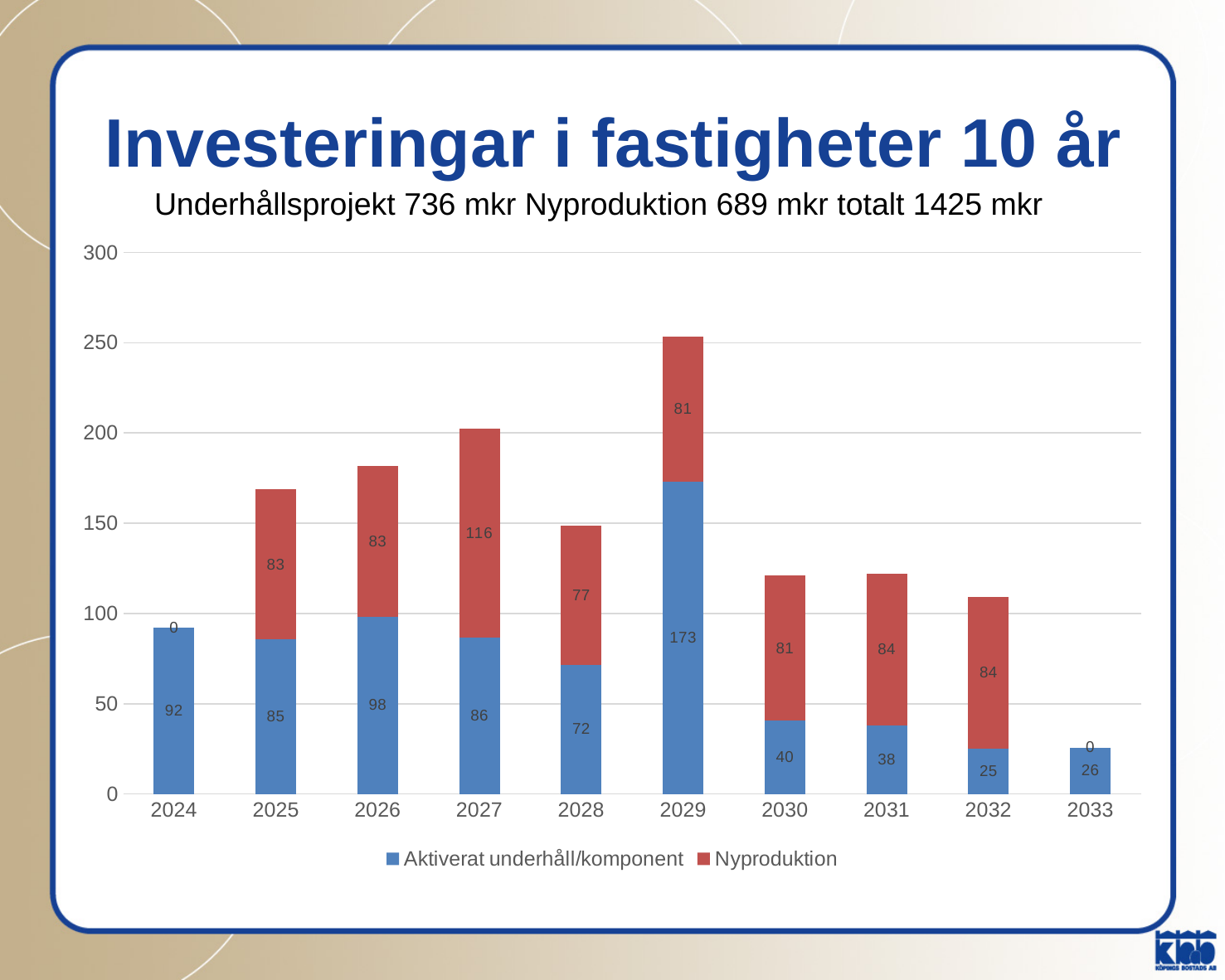
What is the total of the stacked bar for 2029? 254 What is the value of Nyproduktion for 2027? 116 What is the value of Aktiverat underhåll/komponent for 2029? 173 What is the value of Aktiverat underhåll/komponent for 2032? 25 Which year has the highest value for Aktiverat underhåll/komponent? 2029 How many series does the legend list? 2 How many years are shown on the x axis? 10 What type of chart is shown on the slide? stacked bar chart Which is larger, the Aktiverat underhåll/komponent value for 2026 or for 2028? 2026 Which year has the lowest value for Aktiverat underhåll/komponent? 2032 What is the subtitle shown above the chart? Underhållsprojekt 736 mkr Nyproduktion 689 mkr totalt 1425 mkr What is the difference between the Nyproduktion values for 2027 and 2028? 39